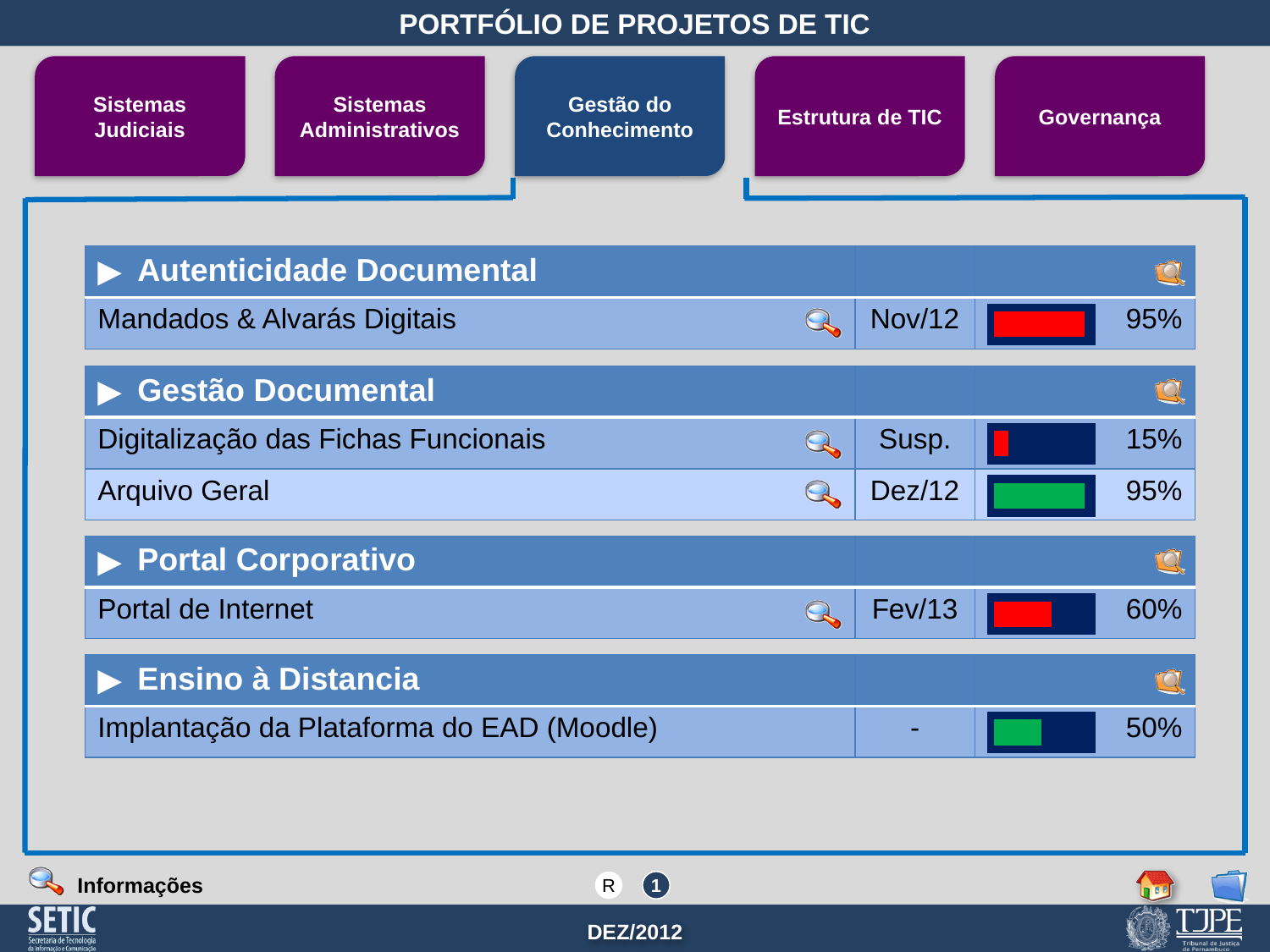
What is the completion percentage shown for Digitalização das Fichas Funcionais? 15% What colour is the progress bar for Arquivo Geral? Green What date is shown next to Arquivo Geral? Dez/12 What is the difference in percentage points between the completion of Arquivo Geral and Digitalização das Fichas Funcionais? 80 What kind of chart is used to show each project's progress? Bar chart What is the completion percentage shown for Implantação da Plataforma do EAD (Moodle)? 50% Which has a higher completion percentage, Portal de Internet or Implantação da Plataforma do EAD (Moodle)? Portal de Internet What is the completion percentage shown for Portal de Internet? 60% What is the completion percentage shown for Mandados & Alvarás Digitais? 95% Which project has the lowest completion percentage? Digitalização das Fichas Funcionais What is the difference in percentage points between the completion of Portal de Internet and Implantação da Plataforma do EAD (Moodle)? 10 How many projects with progress bars are listed on the slide? 5